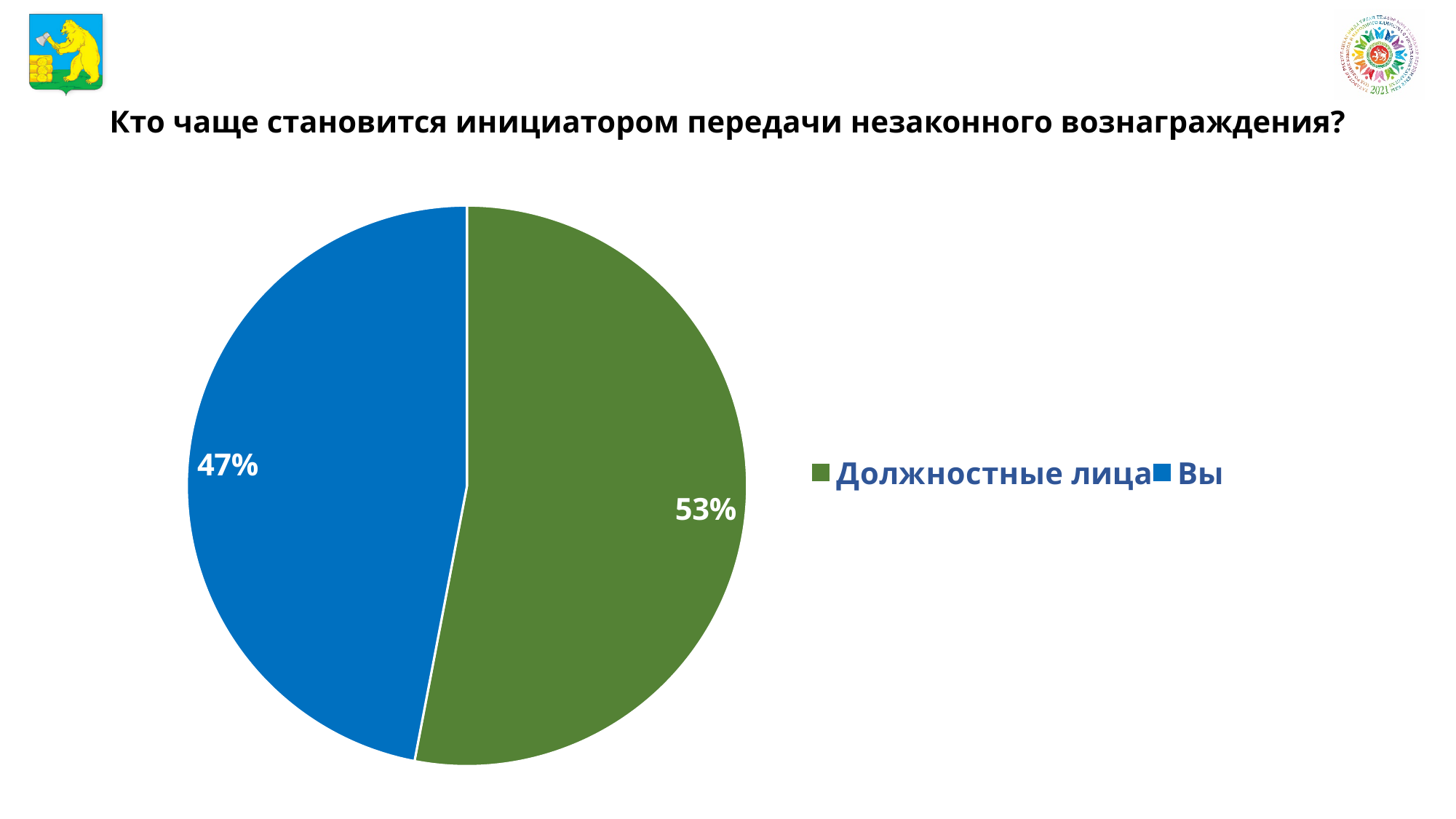
How many slices does the pie chart have? 2 Which category has the smallest slice of the pie? Вы What is the difference in percentage points between the slices for Должностные лица and Вы? 6 Which category has the largest slice of the pie? Должностные лица Which slice is larger, Должностные лица or Вы? Должностные лица What share of the pie does the slice for Должностные лица represent? 53% What kind of chart is shown on the slide? Pie chart What is the title of the chart on the slide? Кто чаще становится инициатором передачи незаконного вознаграждения? How many entries does the legend list? 2 What share of the pie does the slice for Вы represent? 47% What colour is the slice for Должностные лица? Green Is the value for Вы greater or less than 50%? less